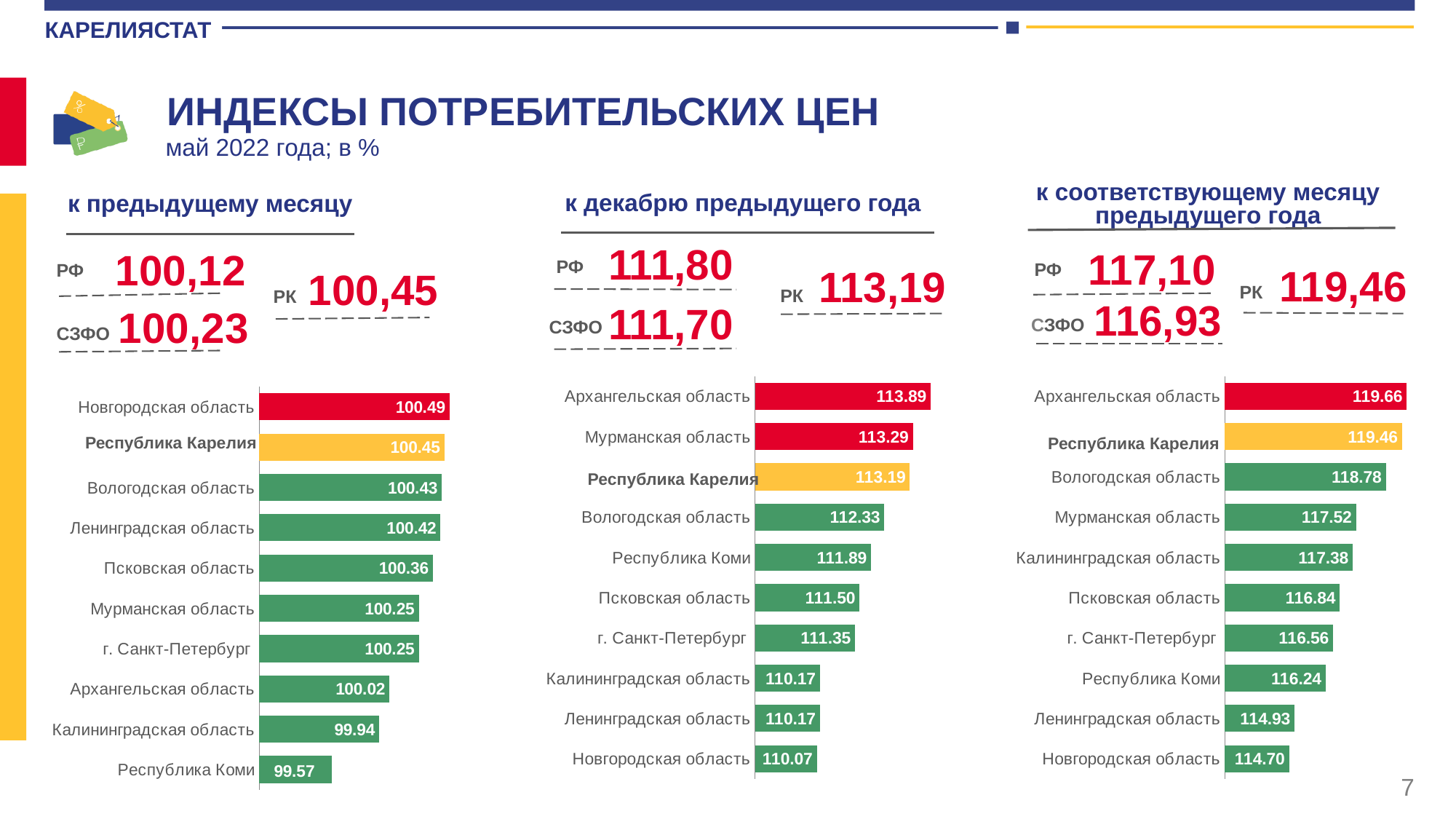
In the chart 'к декабрю предыдущего года', which is larger: Вологодская область or Республика Коми? Вологодская область In the chart 'к декабрю предыдущего года', what is the value for Республика Карелия? 113.19 In the chart 'к предыдущему месяцу', what is the value for Новгородская область? 100.49 What type of chart is used in the chart 'к предыдущему месяцу'? bar chart In the chart 'к декабрю предыдущего года', what is the difference between Архангельская область and Новгородская область? 3.82 In the chart 'к соответствующему месяцу предыдущего года', what colour is the bar for Республика Карелия? yellow In the chart 'к соответствующему месяцу предыдущего года', what is the value for Мурманская область? 117.52 In the chart 'к предыдущему месяцу', how many regions are shown? 10 In the chart 'к соответствующему месяцу предыдущего года', what is the difference between Республика Карелия and Вологодская область? 0.68 In the chart 'к декабрю предыдущего года', which region has the highest value? Архангельская область In the chart 'к предыдущему месяцу', which region has the lowest value? Республика Коми In the chart 'к соответствующему месяцу предыдущего года', which region has the lowest value? Новгородская область